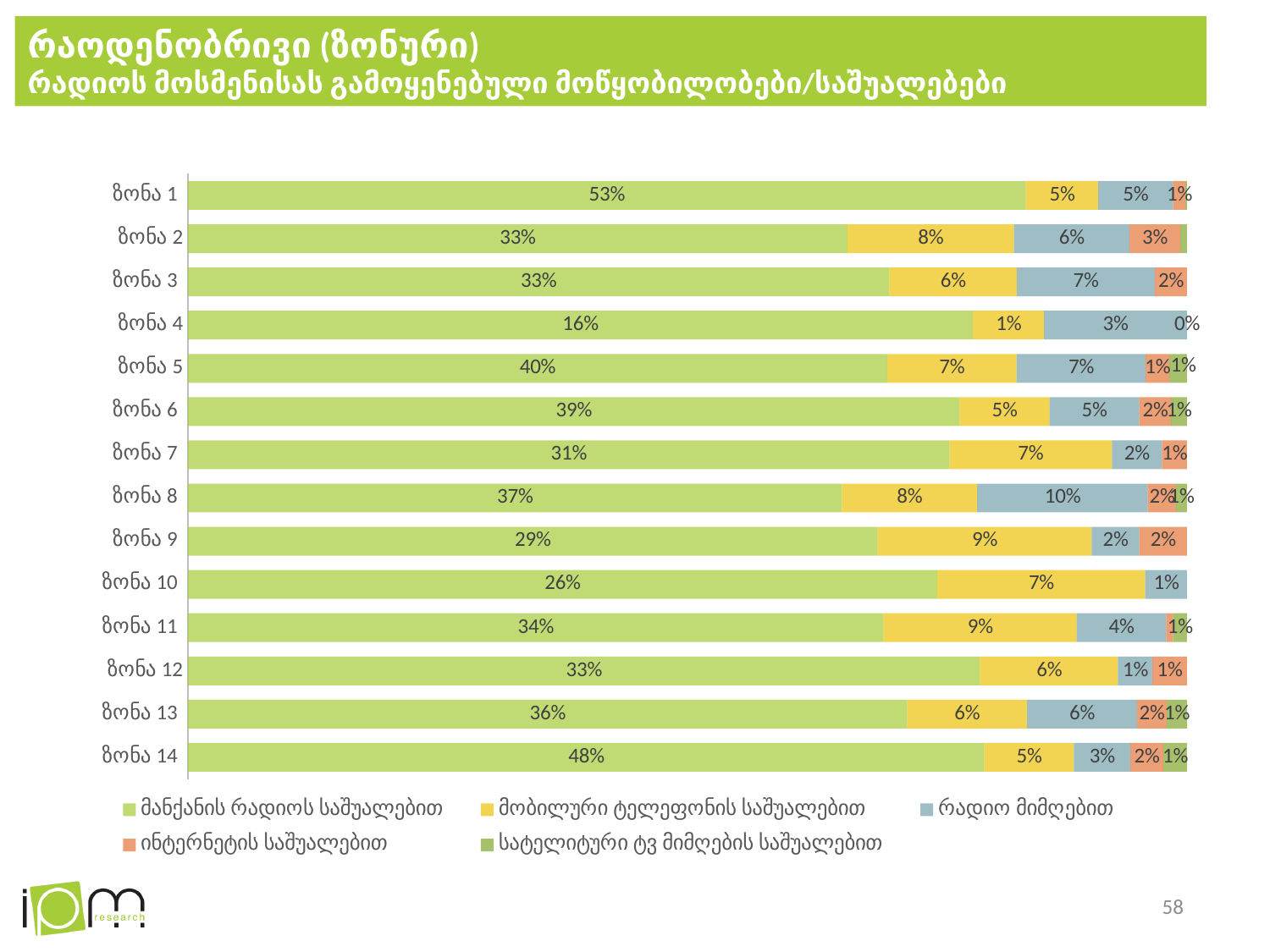
What is the value of the მობილური ტელეფონის საშუალებით segment for ზონა 9? 9% Which zone has the highest value for მანქანის რადიოს საშუალებით? ზონა 1 What type of chart is shown on the slide? Stacked bar chart What is the value of the რადიო მიმღებით segment for ზონა 8? 10% What colour represents მანქანის რადიოს საშუალებით in the legend? Light green How many series does the legend list? 5 Which has a larger მანქანის რადიოს საშუალებით value, ზონა 2 or ზონა 8? ზონა 8 Which zone has the lowest value for მანქანის რადიოს საშუალებით? ზონა 4 How many zones are shown on the chart? 14 What is the total of all labelled segments for ზონა 14? 59% What is the difference between the მანქანის რადიოს საშუალებით values for ზონა 1 and ზონა 14? 5 percentage points What percentage is shown for ზონა 1 in the მანქანის რადიოს საშუალებით series? 53%